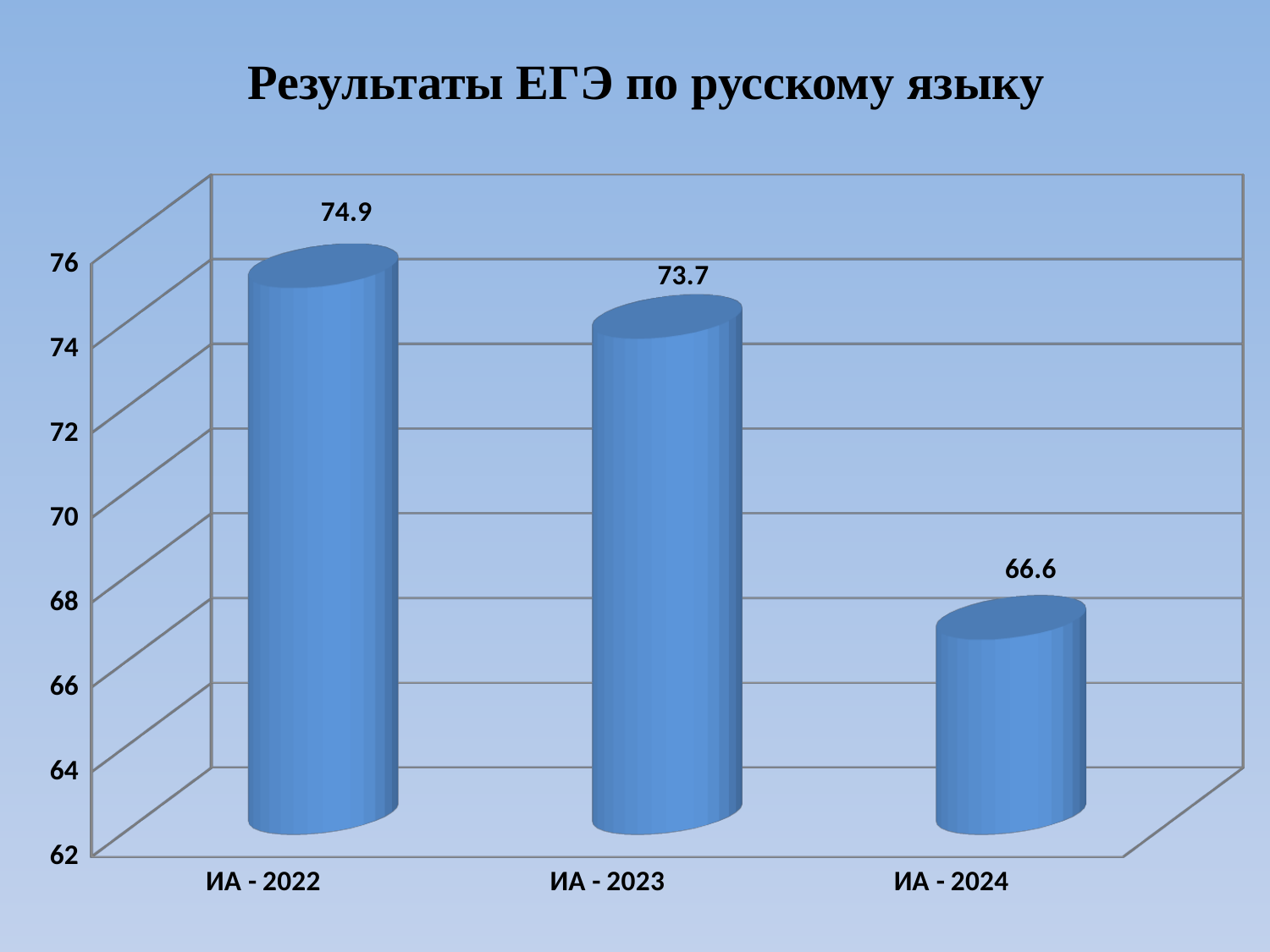
Which is larger, the value for ИА - 2023 or the value for ИА - 2024? ИА - 2023 What is the value for ИА - 2024? 66.6 What is the difference between the values for ИА - 2022 and ИА - 2023? 1.2 What is the value for ИА - 2022? 74.9 Do the values rise or fall from ИА - 2022 to ИА - 2024? fall What is the difference between the values for ИА - 2022 and ИА - 2024? 8.3 What kind of chart is shown on the slide? bar chart How many categories are shown on the chart? 3 Which category has the lowest value? ИА - 2024 Is the value for ИА - 2024 greater or less than 68? less Which category has the highest value? ИА - 2022 What is the value for ИА - 2023? 73.7